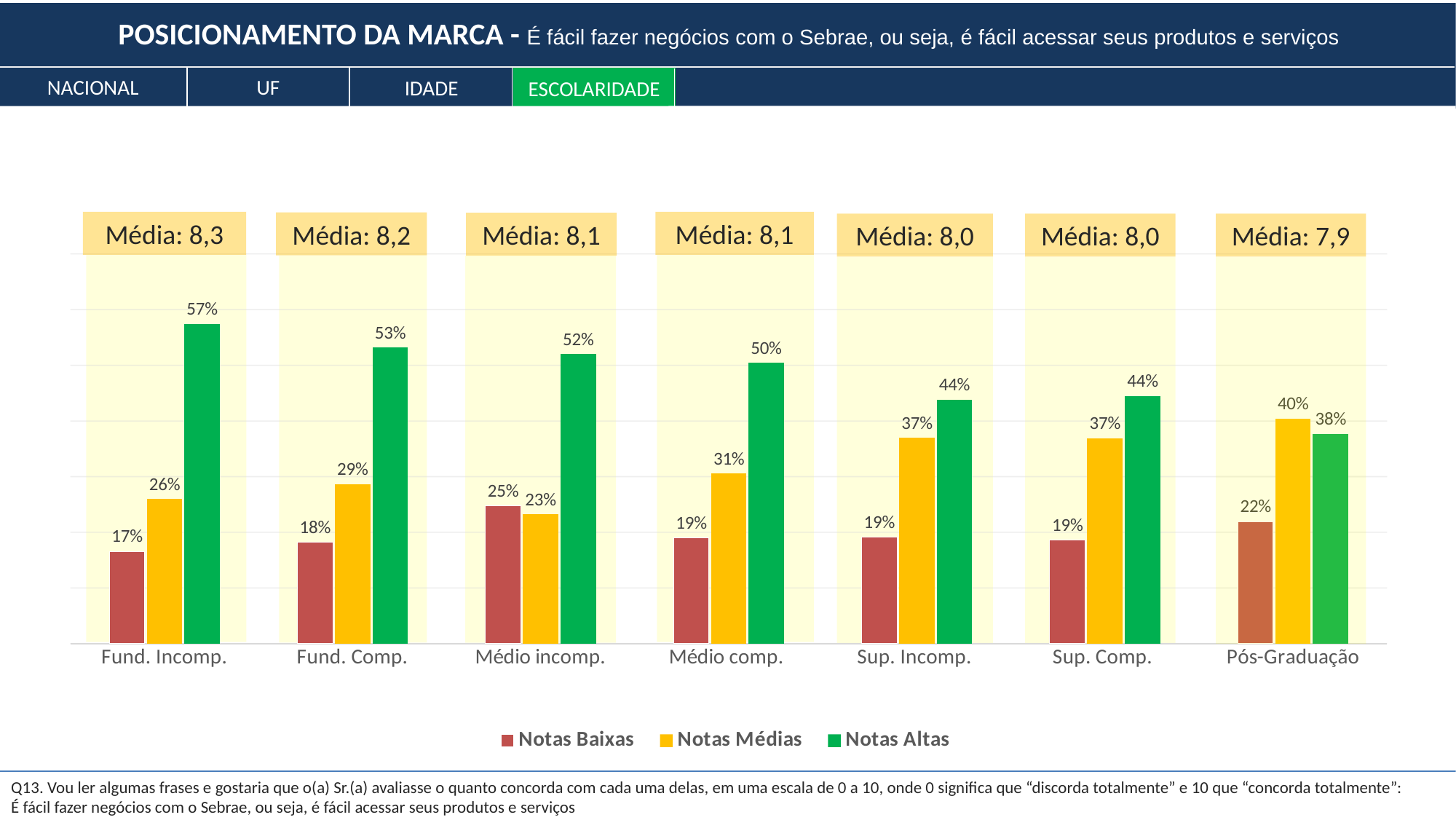
Which is larger for Pós-Graduação: Notas Médias or Notas Altas? Notas Médias How many series does the legend list? 3 How many education categories are shown on the x axis? 7 What is the difference between Notas Altas and Notas Baixas for Fund. Comp.? 35% What is the value of Notas Altas for Fund. Incomp.? 57% What kind of chart is shown on the slide? Bar chart What is the Média shown above the Sup. Comp. category? 8,0 What is the value of Notas Baixas for Médio incomp.? 25% Do the Notas Altas values rise or fall from Fund. Incomp. to Pós-Graduação? Fall Which category has the highest Notas Altas value? Fund. Incomp. What is the value of Notas Médias for Pós-Graduação? 40% Which category has the lowest Notas Baixas value? Fund. Incomp.